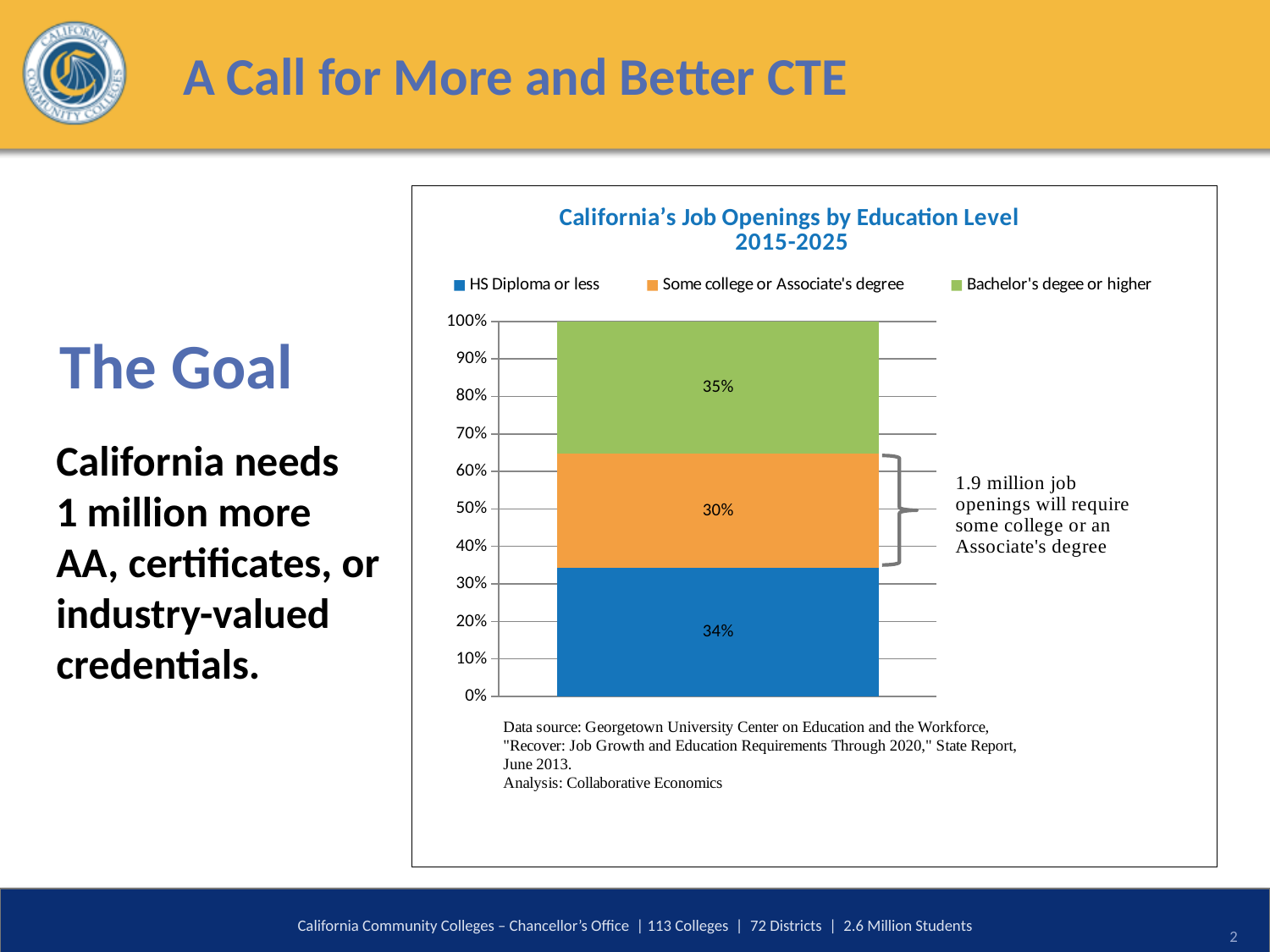
Which education level accounts for the largest share of job openings? Bachelor's degee or higher How many series does the legend list? 3 What percentage of California's job openings 2015-2025 require a HS Diploma or less? 34% What percentage of job openings require some college or an Associate's degree? 30% Which education level accounts for the smallest share of job openings? Some college or Associate's degree According to the annotation, how many job openings will require some college or an Associate's degree? 1.9 million What percentage of job openings require a Bachelor's degree or higher? 35% Which is larger: the share for HS Diploma or less or the share for Some college or Associate's degree? HS Diploma or less What is the title of the chart? California's Job Openings by Education Level 2015-2025 What kind of chart is shown on the slide? Stacked bar chart What is the difference in percentage points between the Bachelor's degree or higher segment and the Some college or Associate's degree segment? 5 Which colour represents the Some college or Associate's degree series? Orange